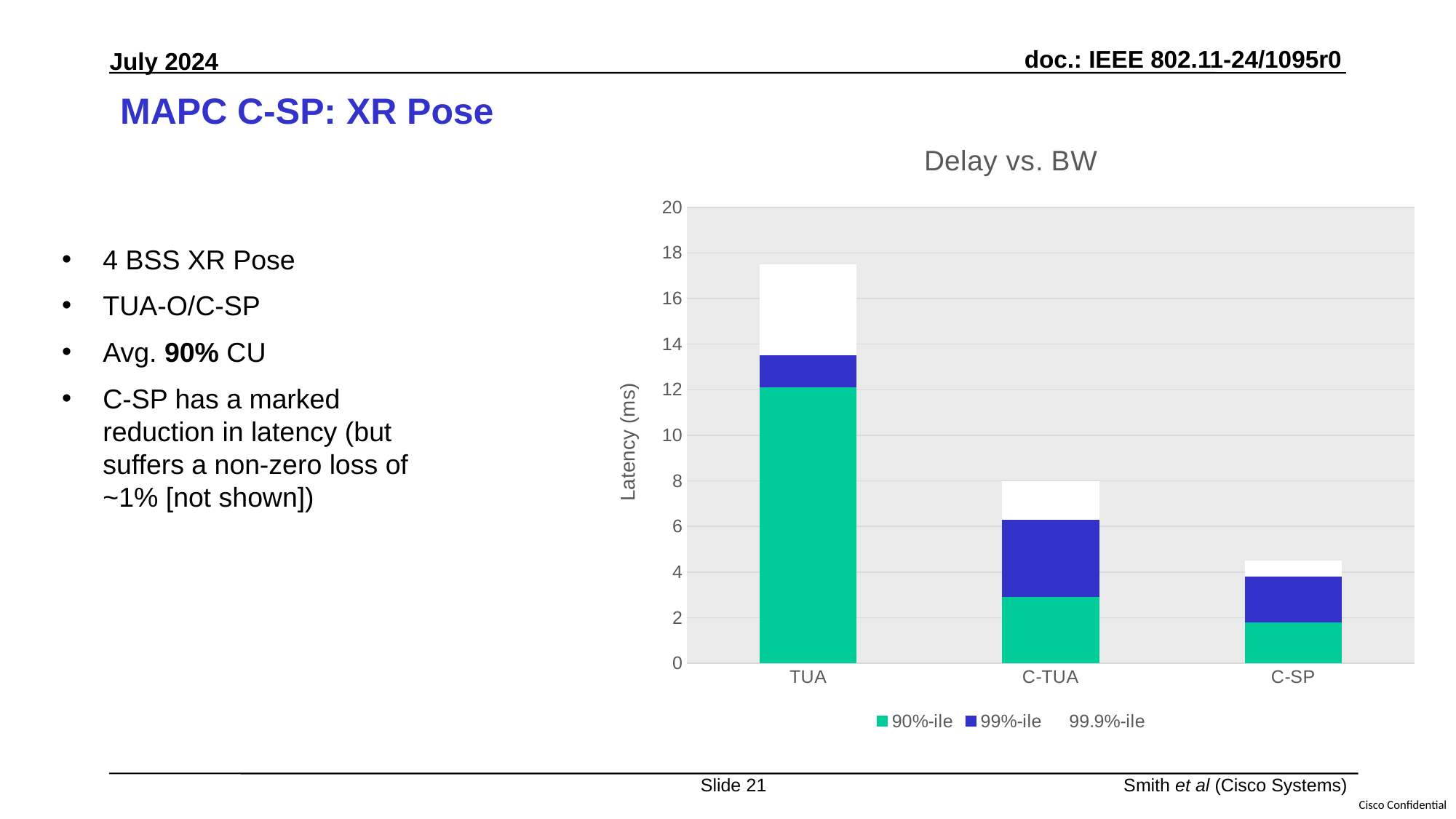
Is the total height of the TUA bar greater or less than 16? greater Is the 90%-ile value for C-TUA greater or less than 4? less What is the label of the vertical axis? Latency (ms) Which category has the shortest bar? C-SP How many series does the legend list? 3 How many categories are shown on the x axis? 3 Is the total height of the C-SP bar greater or less than 6? less What kind of chart is shown on the slide? bar chart What is the title of the chart? Delay vs. BW Do the bar heights rise or fall from left to right across the x axis? fall Which category has the tallest bar? TUA